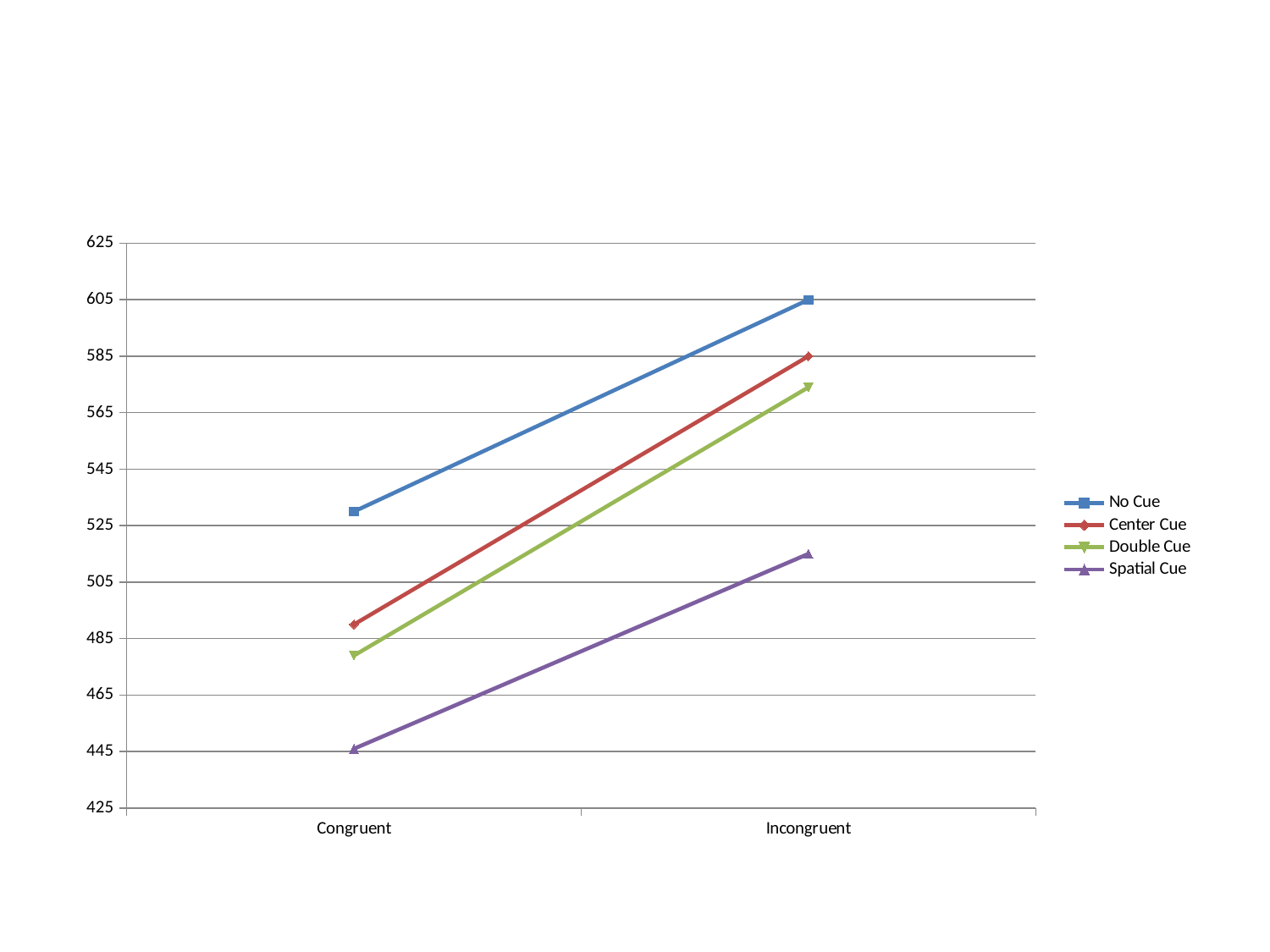
Is the value for Spatial Cue at Congruent greater or less than 465? less How many series does the legend list? 4 At Congruent, which is larger: Center Cue or Double Cue? Center Cue What is the value for No Cue at Incongruent? 605 How many categories are shown on the x axis? 2 What is the value for Center Cue at Incongruent? 585 Which series has the lowest value at Congruent? Spatial Cue Which series has the highest value at Incongruent? No Cue Is the value for Double Cue at Incongruent greater or less than 565? greater Do the values for No Cue rise or fall from Congruent to Incongruent? rise What kind of chart is shown on the slide? line chart Is the value for Spatial Cue at Incongruent greater or less than 505? greater